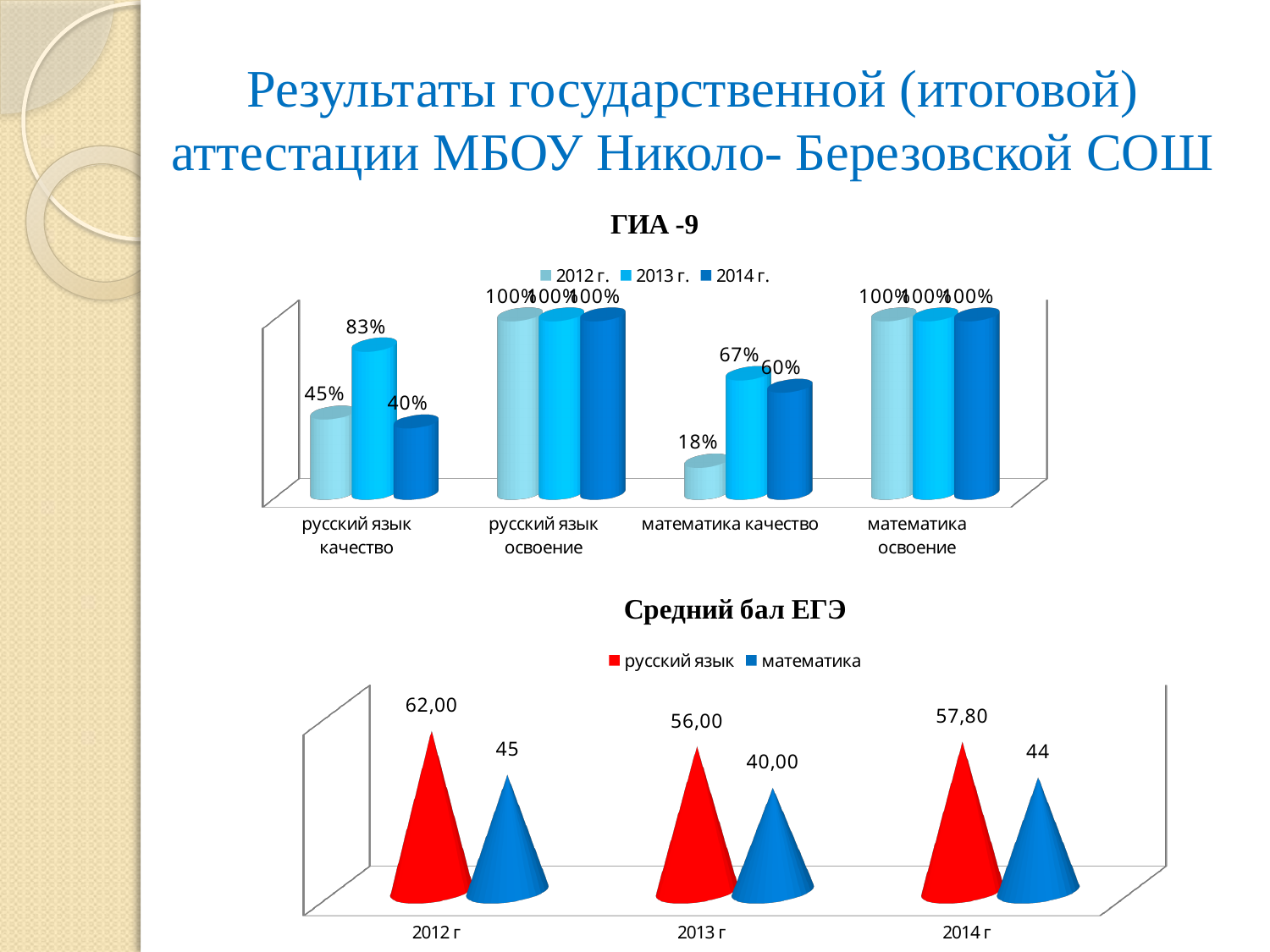
In the Средний бал ЕГЭ chart, which is larger in 2014 г: русский язык or математика? русский язык In the ГИА -9 chart, which year has the lowest value in the category русский язык качество? 2014 г. In the ГИА -9 chart, what is the value for 2012 г. in the category математика качество? 18% In the Средний бал ЕГЭ chart, what is the value for русский язык in 2012 г? 62,00 In the Средний бал ЕГЭ chart, what colour represents математика in the legend? blue In the ГИА -9 chart, how many categories are shown on the x axis? 4 In the ГИА -9 chart, what is the value for 2013 г. in the category русский язык качество? 83% In the Средний бал ЕГЭ chart, what is the value for математика in 2013 г? 40,00 In the Средний бал ЕГЭ chart, which year has the highest value for русский язык? 2012 г In the ГИА -9 chart, what is the value for 2014 г. in the category математика качество? 60% In the ГИА -9 chart, how many series does the legend list? 3 In the ГИА -9 chart, what is the difference between the 2013 г. and 2012 г. values in the category математика качество? 49%